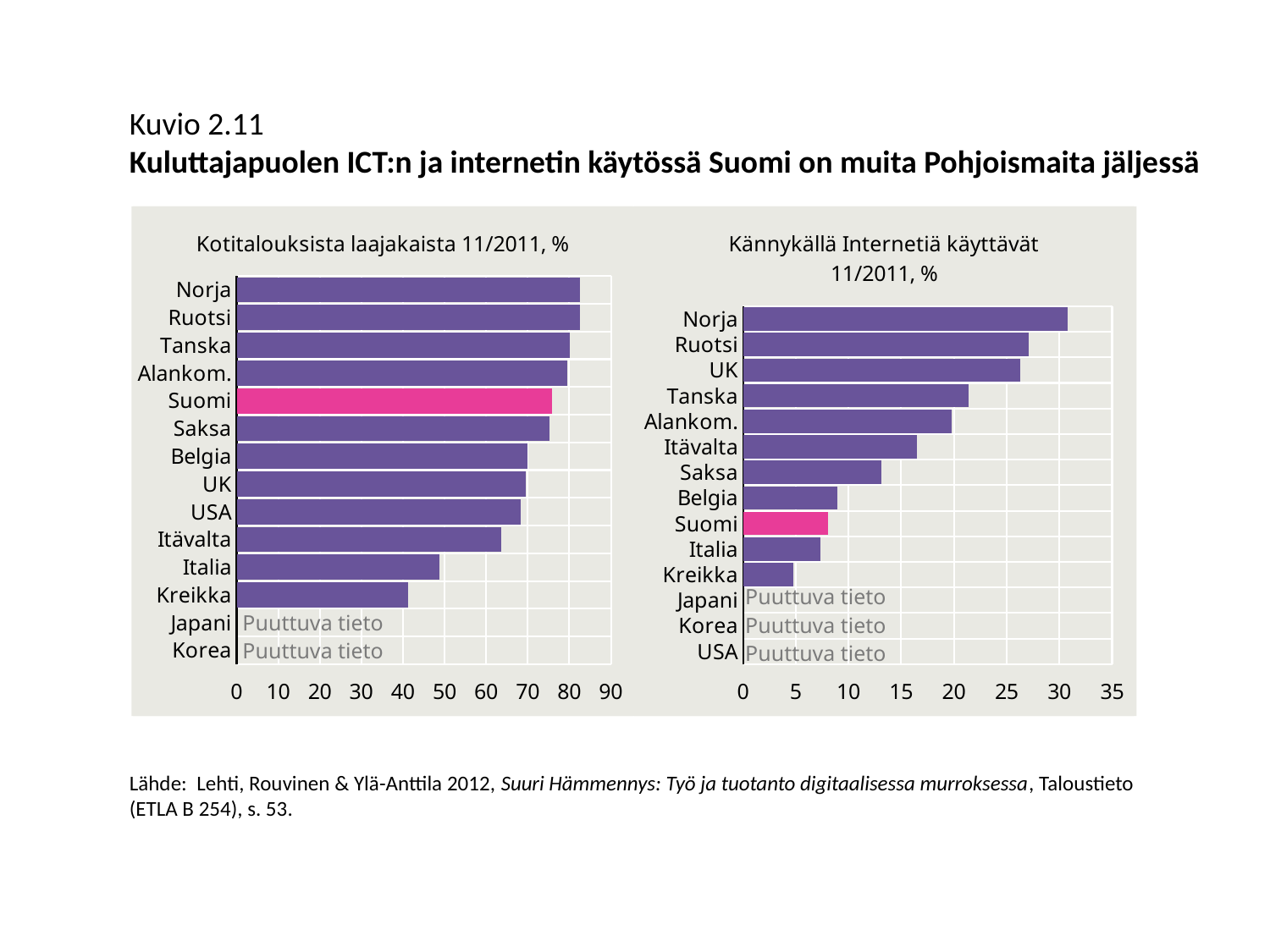
In the right chart, 'Kännykällä Internetiä käyttävät 11/2011, %', which country with a plotted bar has the lowest value? Kreikka In the right chart, 'Kännykällä Internetiä käyttävät 11/2011, %', which is larger, the value for Tanska or the value for Saksa? Tanska What kind of chart is the left chart, 'Kotitalouksista laajakaista 11/2011, %'? bar chart How many countries are listed on the y axis of the right chart, 'Kännykällä Internetiä käyttävät 11/2011, %'? 14 In the right chart, 'Kännykällä Internetiä käyttävät 11/2011, %', is the value for Suomi greater or less than 10? less In the left chart, 'Kotitalouksista laajakaista 11/2011, %', which country with a plotted bar has the lowest value? Kreikka In the right chart, 'Kännykällä Internetiä käyttävät 11/2011, %', is the value for Norja greater or less than 30? greater In the left chart, 'Kotitalouksista laajakaista 11/2011, %', is the value for Suomi greater or less than 70? greater In the left chart, 'Kotitalouksista laajakaista 11/2011, %', which is larger, the value for Suomi or the value for Itävalta? Suomi In the right chart, 'Kännykällä Internetiä käyttävät 11/2011, %', which country has the highest value? Norja In the left chart, 'Kotitalouksista laajakaista 11/2011, %', which countries are marked 'Puuttuva tieto' (missing data)? Japani and Korea